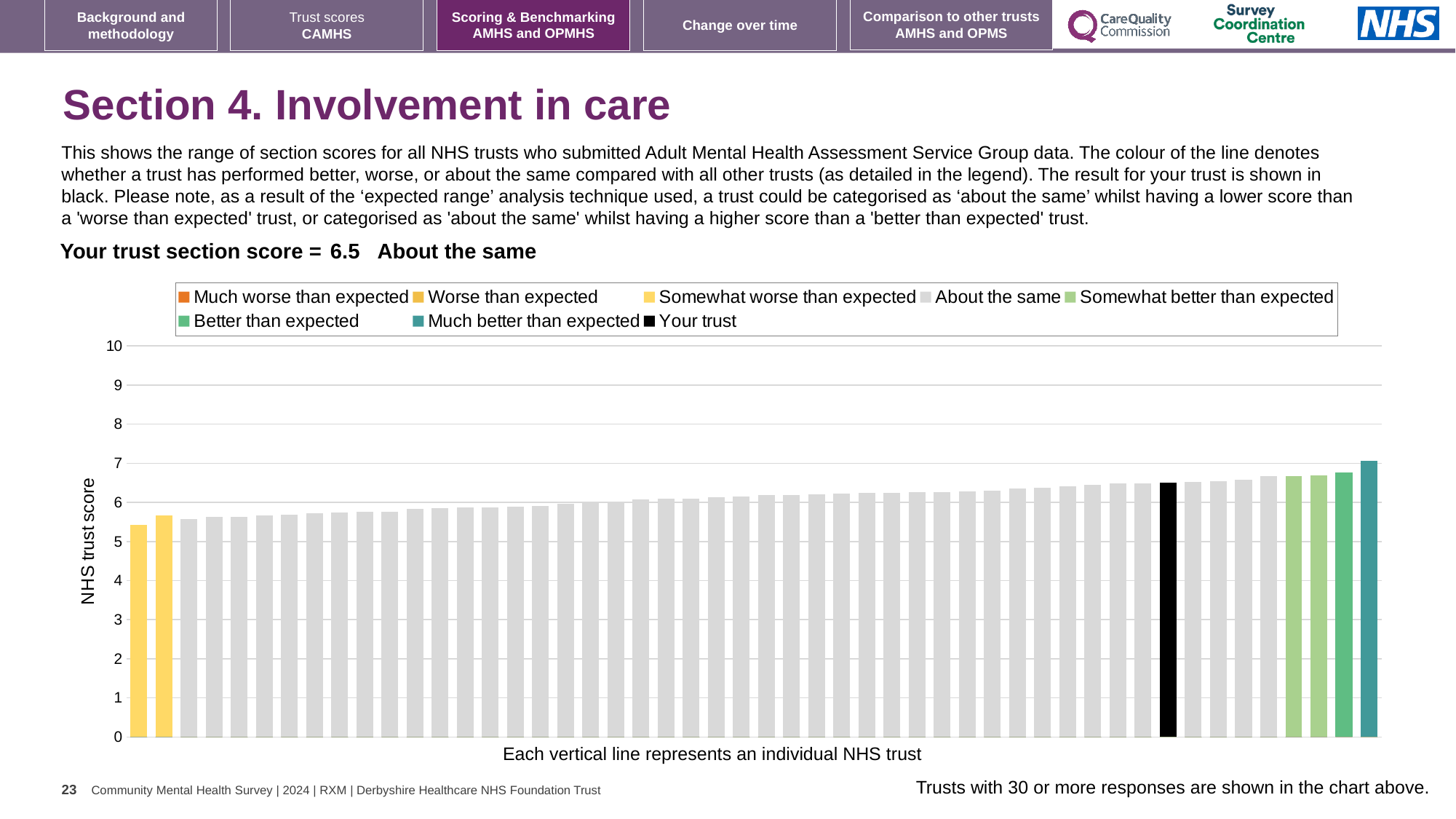
What kind of chart is shown on the slide? bar chart What colour is used for the bar representing your trust? black How many entries does the chart legend list? 8 Is the value of the highest bar in the chart greater or less than 6? greater Is the value for your trust (the black bar) larger or smaller than the value of the rightmost bar? smaller Which legend category does the highest bar in the chart belong to? Much better than expected Is the value for your trust (the black bar) greater or less than 6? greater What is the label on the vertical axis of the chart? NHS trust score What is the section score for your trust? 6.5 Is the value of the lowest bar in the chart greater or less than 6? less Do the bar values rise or fall moving from left to right along the x axis? rise